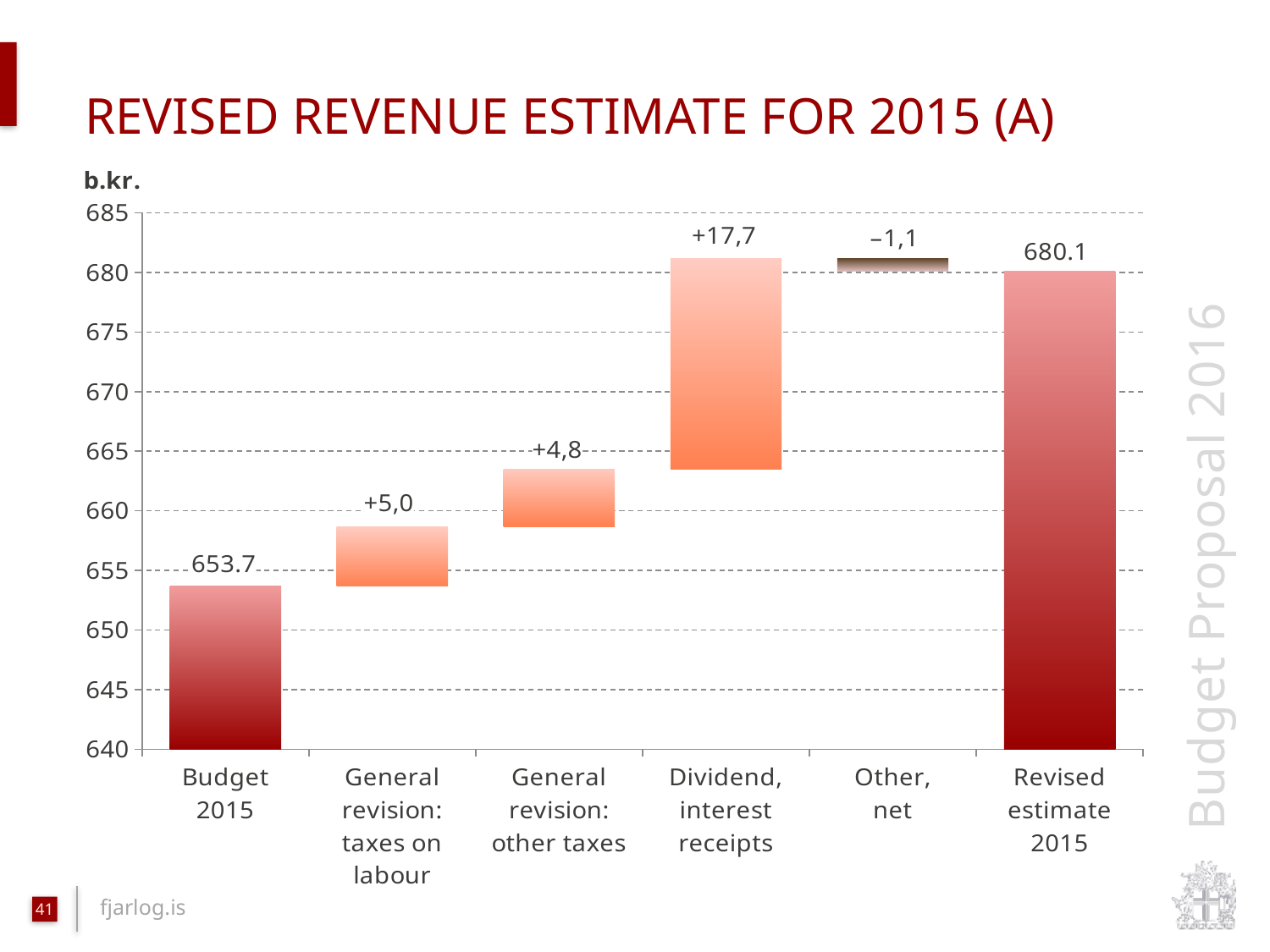
Which adjustment category has the largest positive value? Dividend, interest receipts What is the difference between the Revised estimate 2015 and the Budget 2015? 26.4 What is the value shown for Other, net? –1,1 What is the value for Budget 2015? 653.7 What unit is shown above the y axis? b.kr. Which is larger, the value for General revision: taxes on labour or General revision: other taxes? General revision: taxes on labour How many categories are shown on the x axis? 6 What is the value shown for Dividend, interest receipts? +17,7 What is the value shown for General revision: other taxes? +4,8 What is the value for Revised estimate 2015? 680.1 What is the value shown for General revision: taxes on labour? +5,0 Which category is the only one with a negative value? Other, net